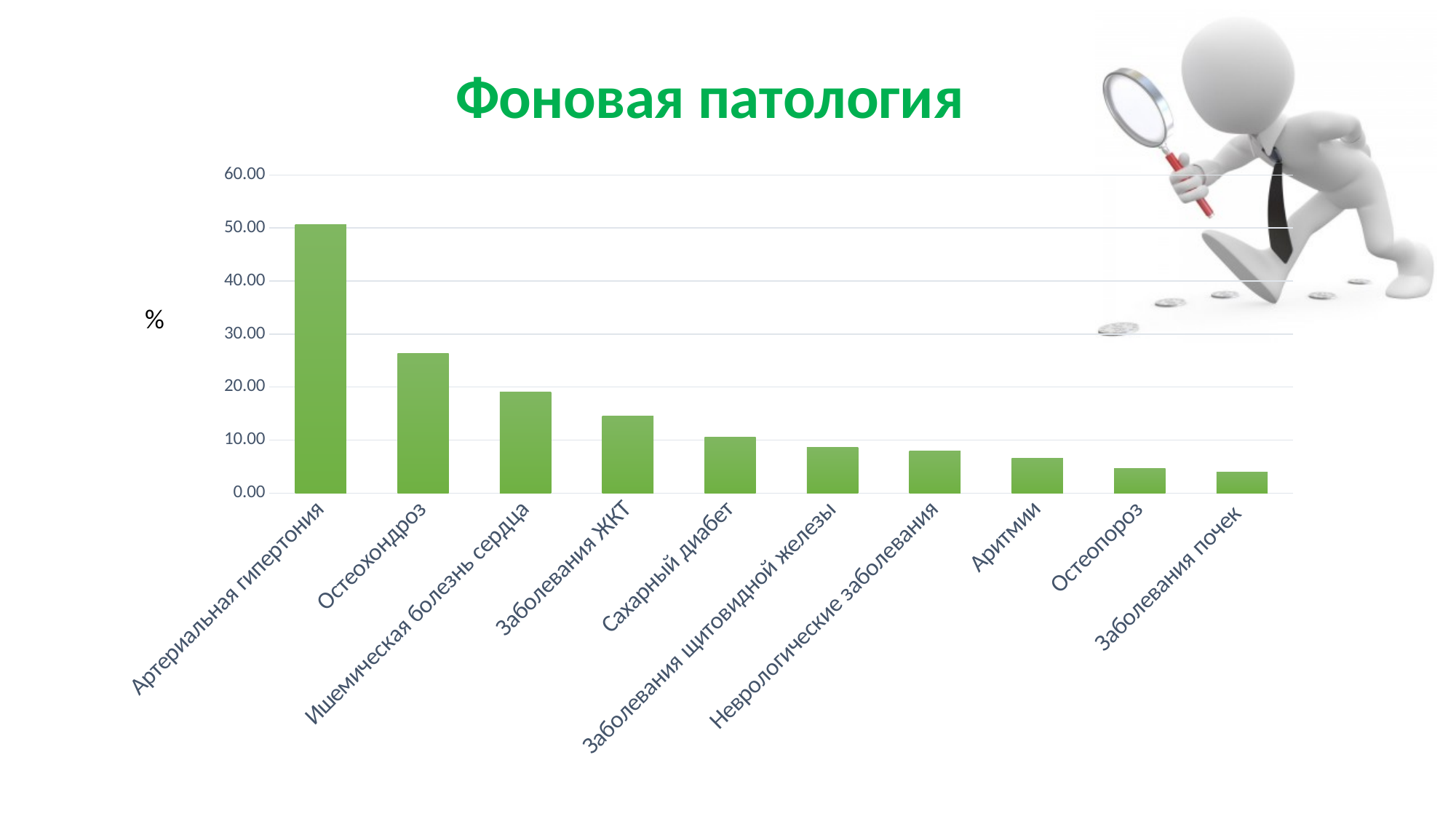
Is the value for Заболевания почек greater or less than 10.00? less What unit label is shown next to the vertical axis? % Is the value for Заболевания ЖКТ greater or less than 10.00? greater What is the title of the chart? Фоновая патология Which category has the lowest value? Заболевания почек Is the value for Остеохондроз greater or less than 20.00? greater Do the values rise or fall from left to right along the x axis? fall What kind of chart is shown on the slide? bar chart How many categories are plotted in the chart? 10 Which is larger, the value for Остеохондроз or the value for Ишемическая болезнь сердца? Остеохондроз Which category has the highest value? Артериальная гипертония